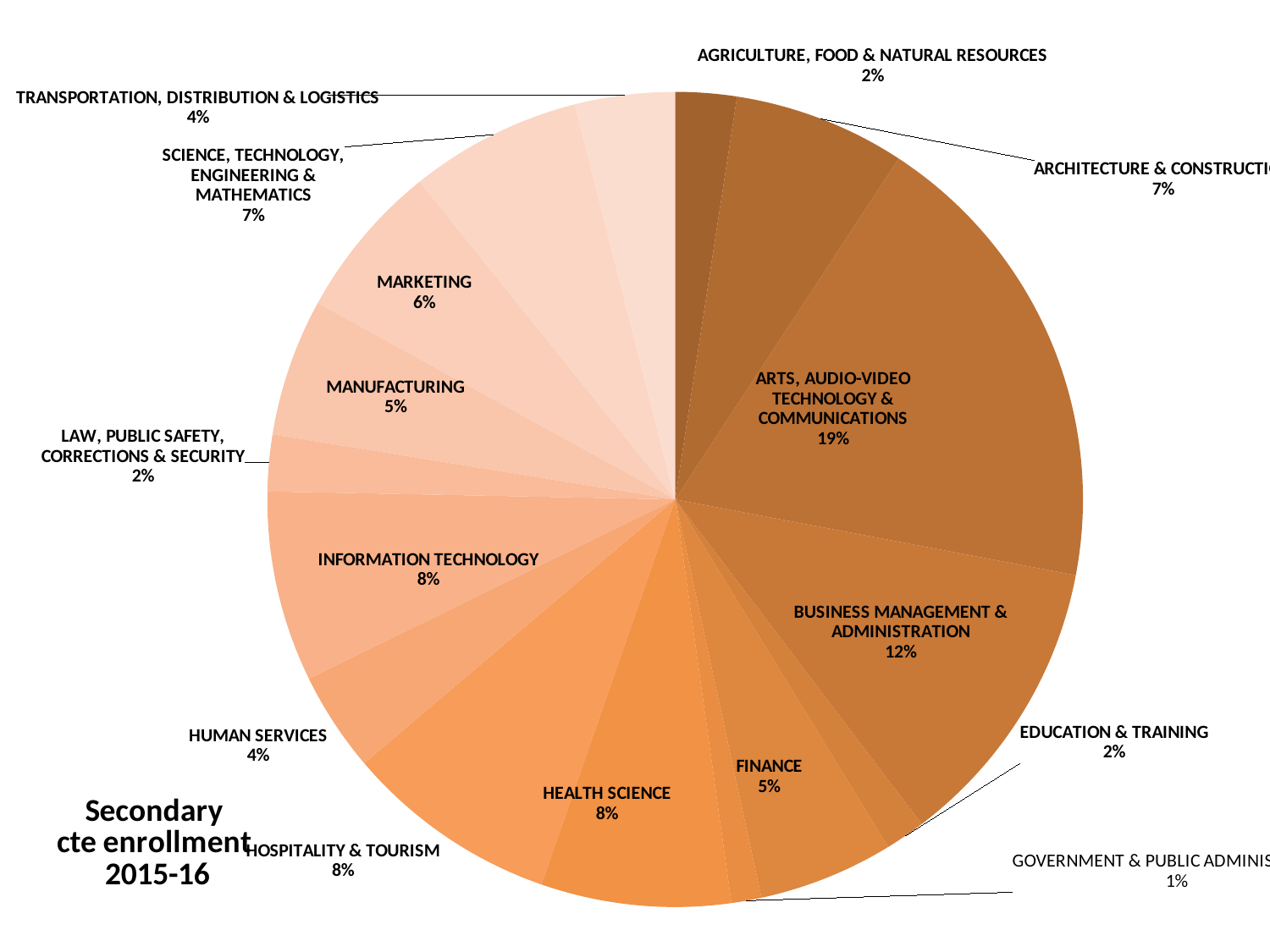
Which category has the smallest slice of the pie? Government & Public Administration How many categories are shown in the pie chart? 16 What is the title of the chart? Secondary cte enrollment 2015-16 Which category has the largest slice of the pie? Arts, Audio-Video Technology & Communications Which is larger, the share for Manufacturing or the share for Information Technology? Information Technology What is the value for Marketing? 6% What kind of chart is shown on the slide? Pie chart What share of the pie does Arts, Audio-Video Technology & Communications represent? 19% What is the difference between the shares for Arts, Audio-Video Technology & Communications and Business Management & Administration? 7% What is the value for Business Management & Administration? 12% What is the value for Science, Technology, Engineering & Mathematics? 7% What is the value for Health Science? 8%